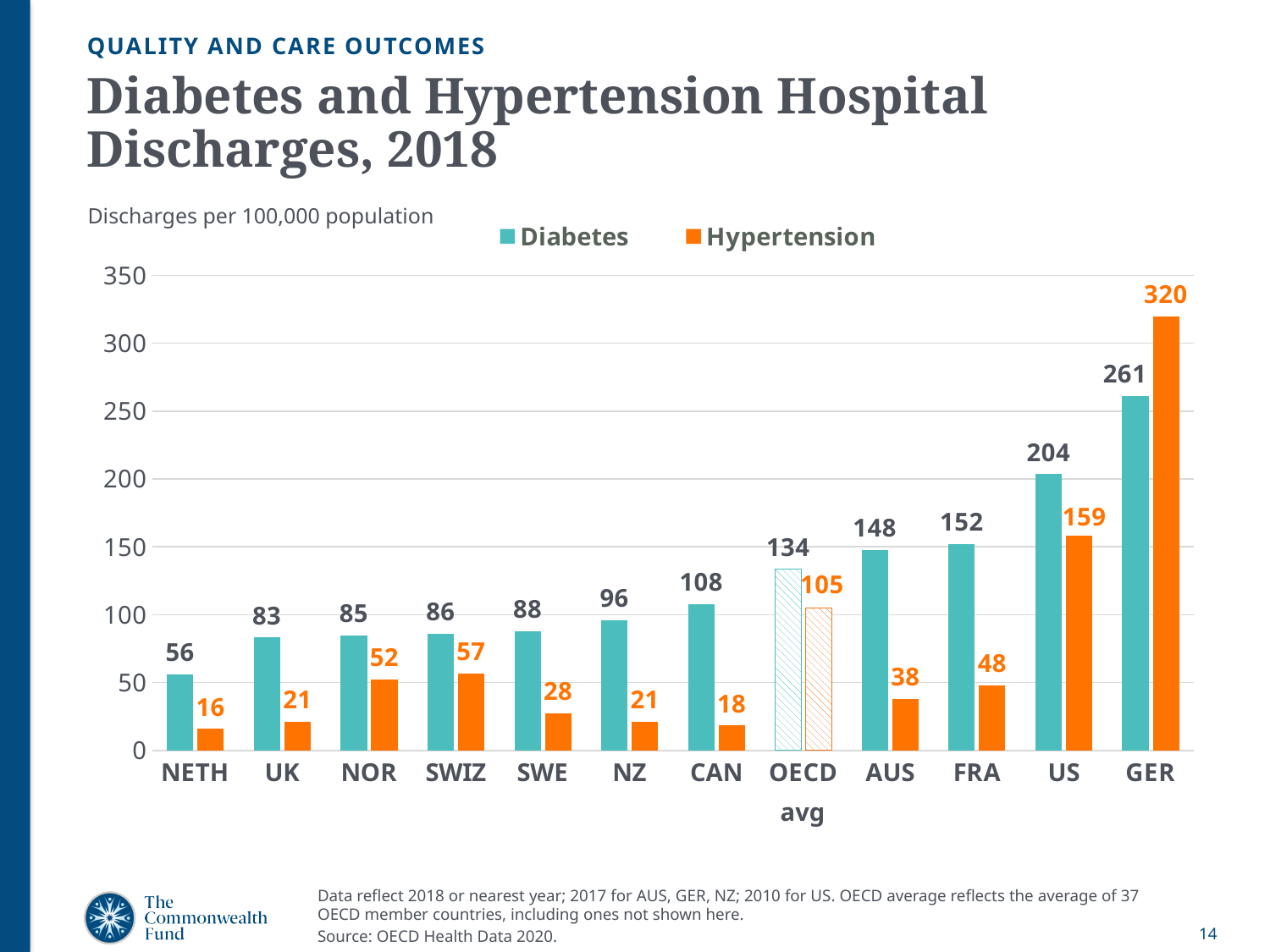
What kind of chart is shown on the slide? Bar chart Do the Diabetes values rise or fall from left to right along the x axis? Rise How many series does the legend list? 2 Which country has the highest Diabetes discharge value? GER Which country has the lowest Hypertension discharge value? NETH What is the Hypertension value for the OECD average? 105 Which is larger, the Diabetes value for France (FRA) or the Diabetes value for Australia (AUS)? FRA What is the Diabetes discharge value for the US? 204 What unit is given for the values in the chart? Discharges per 100,000 population What is the difference between the Diabetes and Hypertension values for Canada (CAN)? 90 How many categories are shown on the x axis? 12 What is the Hypertension discharge value for Germany (GER)? 320